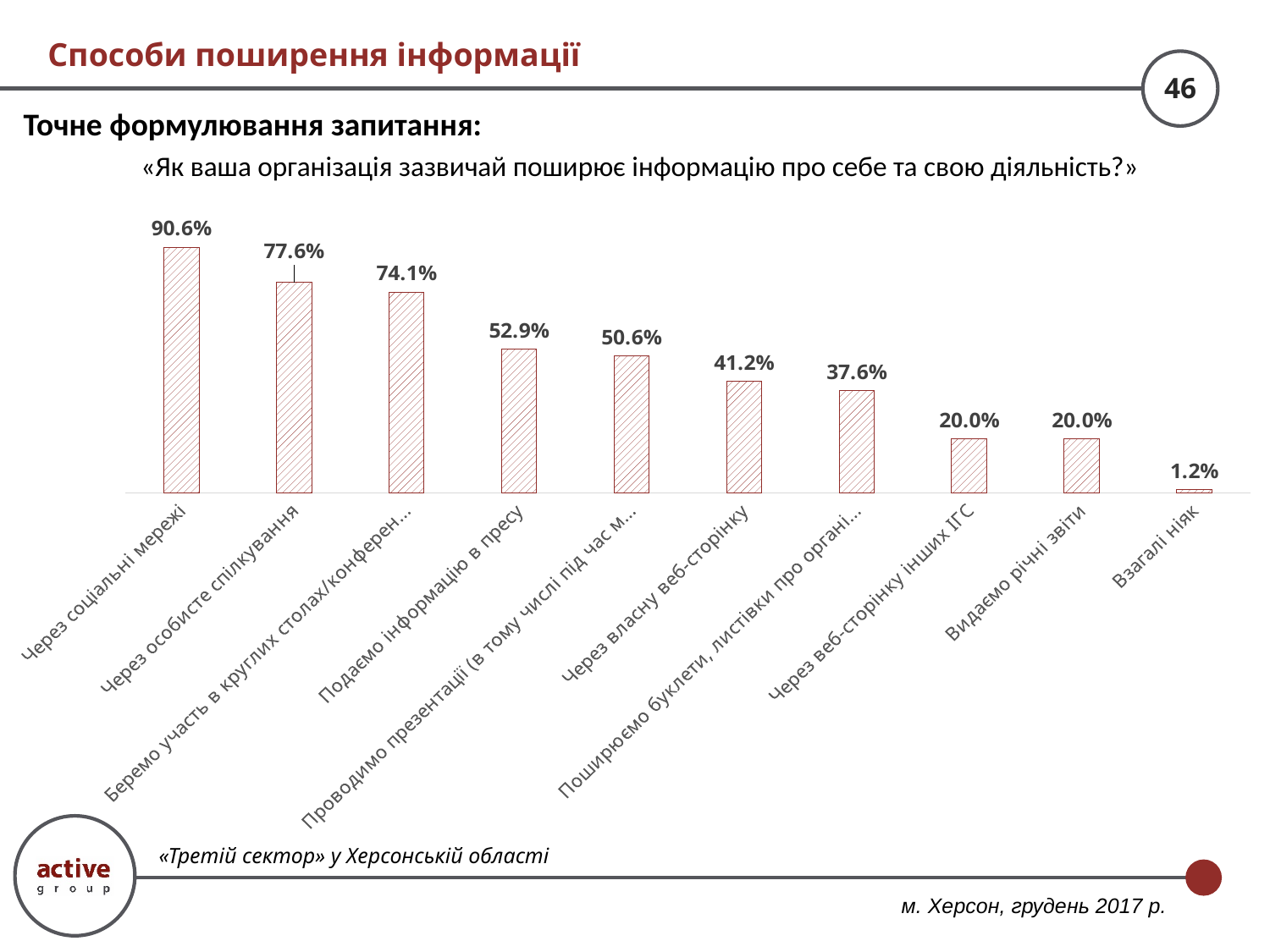
What is the value for "Взагалі ніяк"? 1.2% Which is larger: the value for "Через особисте спілкування" or the value for "Подаємо інформацію в пресу"? Через особисте спілкування Which category has the lowest value? Взагалі ніяк What is the value for "Подаємо інформацію в пресу"? 52.9% Do the values rise or fall from left to right along the x axis? Fall What is the value for "Через соціальні мережі"? 90.6% Which category has the highest value? Через соціальні мережі What is the value for "Видаємо річні звіти"? 20.0% How many categories are shown in the chart? 10 What is the difference between the values for "Через соціальні мережі" and "Через особисте спілкування"? 13.0% What kind of chart is shown on the slide? Bar chart What is the value for "Через власну веб-сторінку"? 41.2%